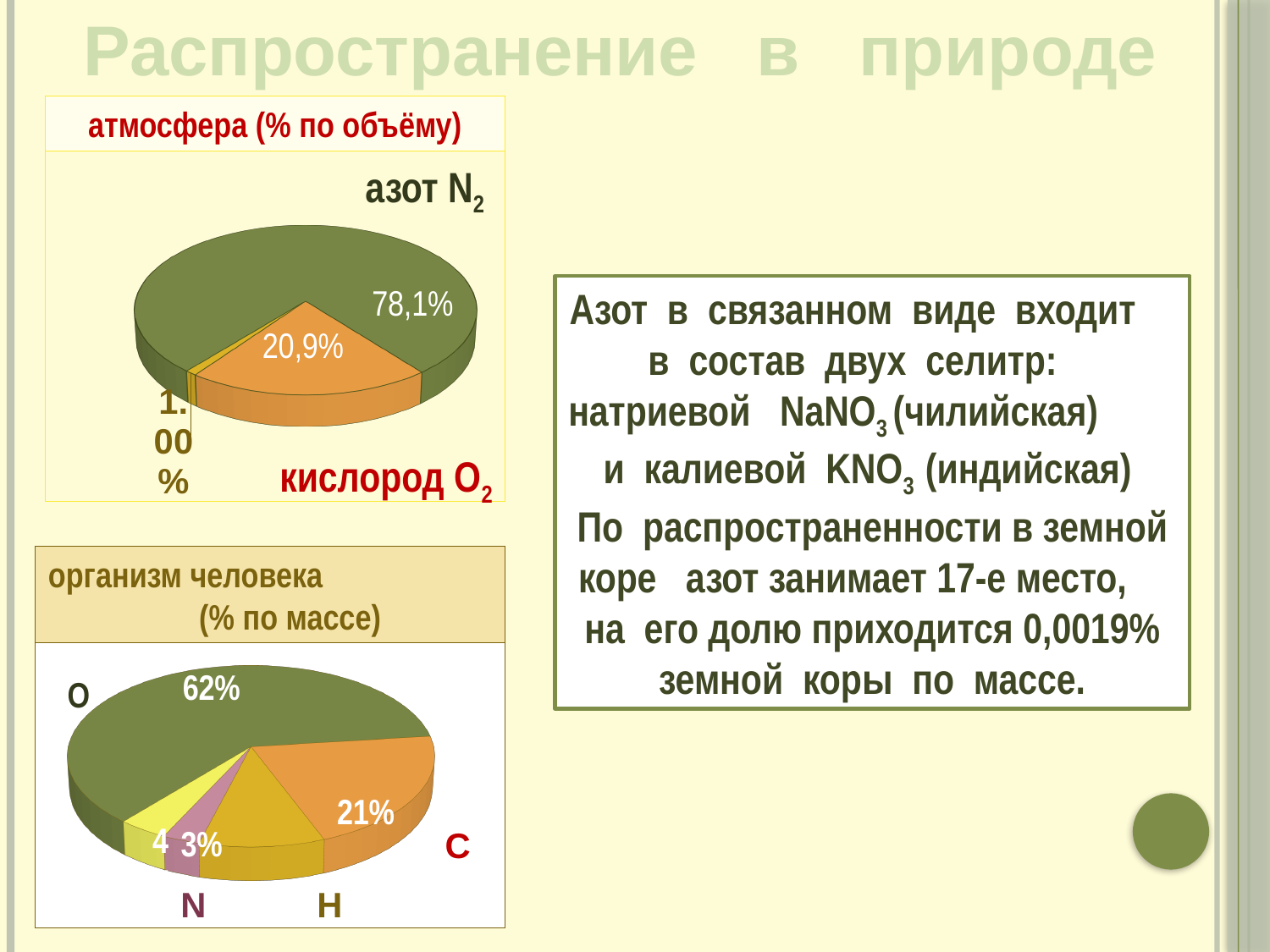
In the top chart 'атмосфера (% по объёму)', what is the value for кислород O2? 20,9% In the bottom chart 'организм человека (% по массе)', what is the value for C? 21% In the top chart 'атмосфера (% по объёму)', which is larger: азот N2 or кислород O2? азот N2 In the bottom chart 'организм человека (% по массе)', what is the value for O? 62% In the bottom chart 'организм человека (% по массе)', which slice is the largest? O What is the title of the top chart on the slide? атмосфера (% по объёму) In the top chart 'атмосфера (% по объёму)', what is the difference between the values for азот N2 and кислород O2? 57,2% What kind of chart is the bottom chart titled 'организм человека (% по массе)'? pie chart In the top chart 'атмосфера (% по объёму)', what is the value for азот N2? 78,1% What kind of chart is the top chart titled 'атмосфера (% по объёму)'? pie chart In the top chart 'атмосфера (% по объёму)', which slice is the largest? азот N2 In the bottom chart 'организм человека (% по массе)', what is the difference between the values for O and C? 41%